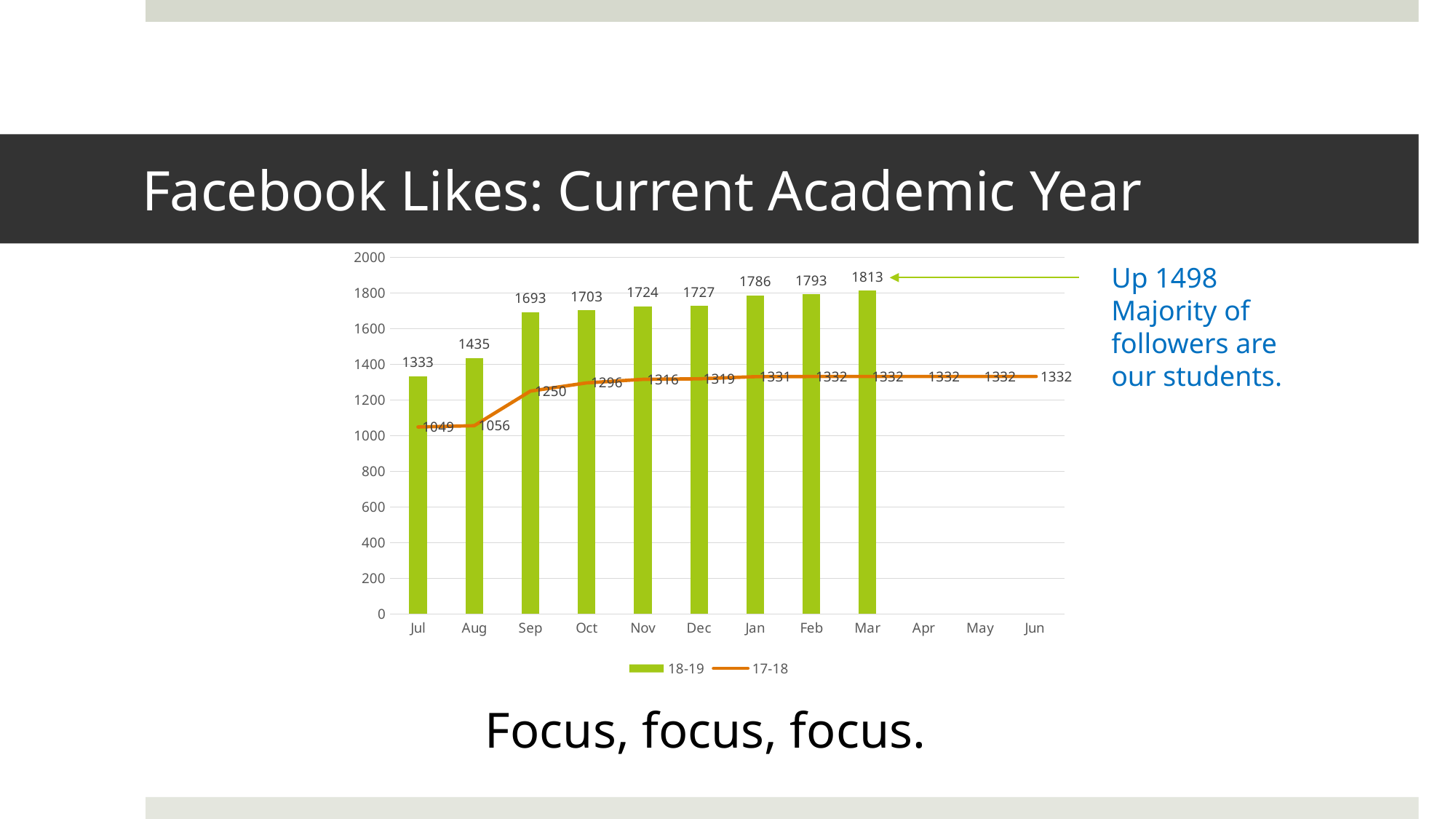
Is the 18-19 value for Sep greater or less than 1600? greater What is the title of the chart slide? Facebook Likes: Current Academic Year How many series does the legend list? 2 Which month has the lowest 17-18 value? Jul What is the 17-18 value for Sep? 1250 How many months have an 18-19 bar plotted? 9 What is the 18-19 value for Mar? 1813 What is the difference between the 18-19 and 17-18 values for Jan? 455 What is the 18-19 value for Jul? 1333 Which is larger for Aug: the 18-19 value or the 17-18 value? 18-19 Which month has the highest 18-19 value? Mar Do the 18-19 values rise or fall from Jul to Mar? rise